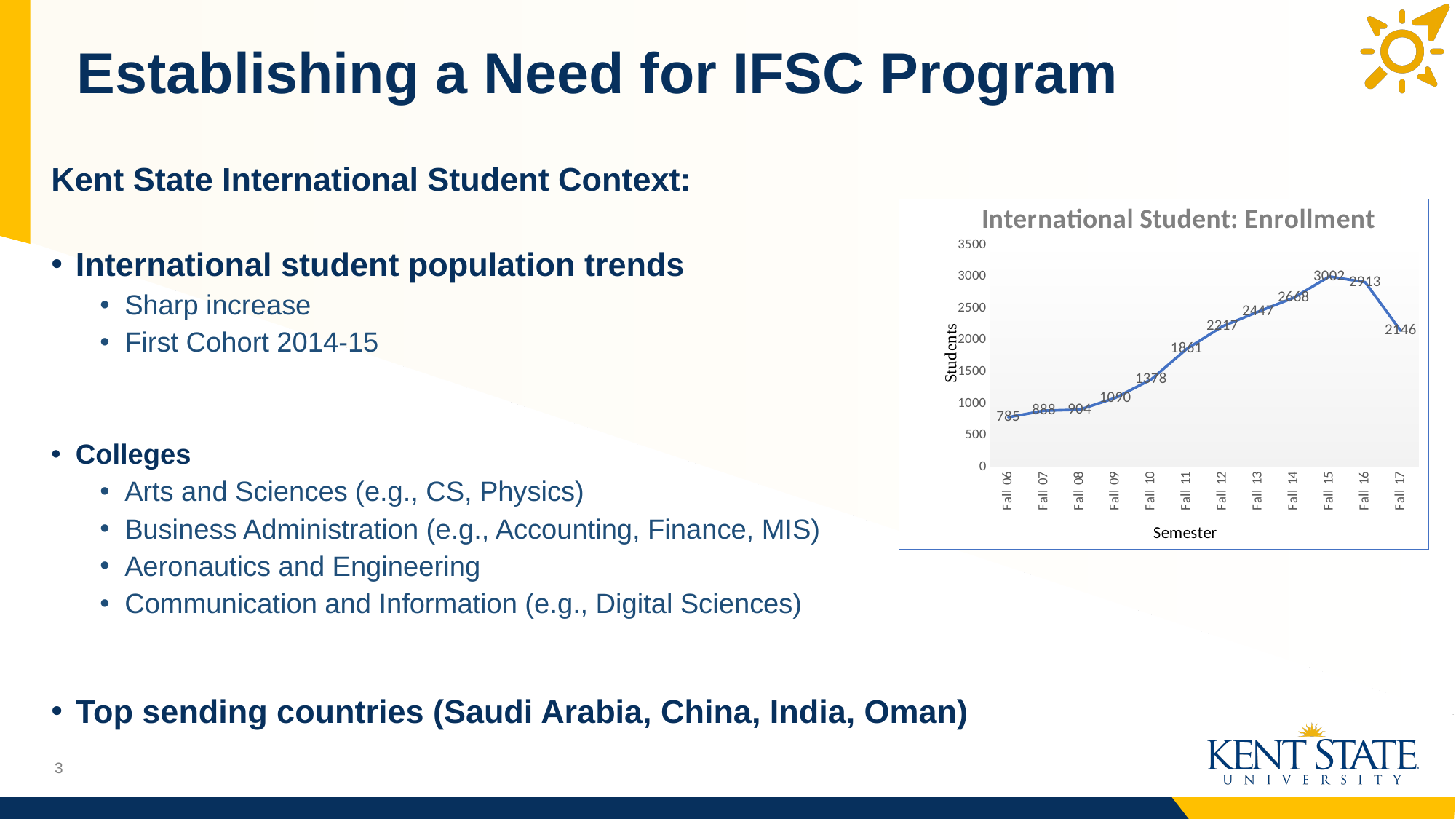
How many semesters are plotted on the x axis of the chart? 12 What is the title of the chart? International Student: Enrollment What is the difference in enrollment between Fall 12 and Fall 11? 356 Which semester has the highest enrollment? Fall 15 What type of chart is shown on the slide? line chart What is the enrollment value for Fall 06? 785 What is the enrollment value for Fall 11? 1861 What is the enrollment value for Fall 17? 2146 Which semester has higher enrollment, Fall 13 or Fall 17? Fall 13 What is the enrollment value for Fall 14? 2668 Which semester has the lowest enrollment? Fall 06 Is the enrollment value for Fall 16 greater or less than 2500? greater